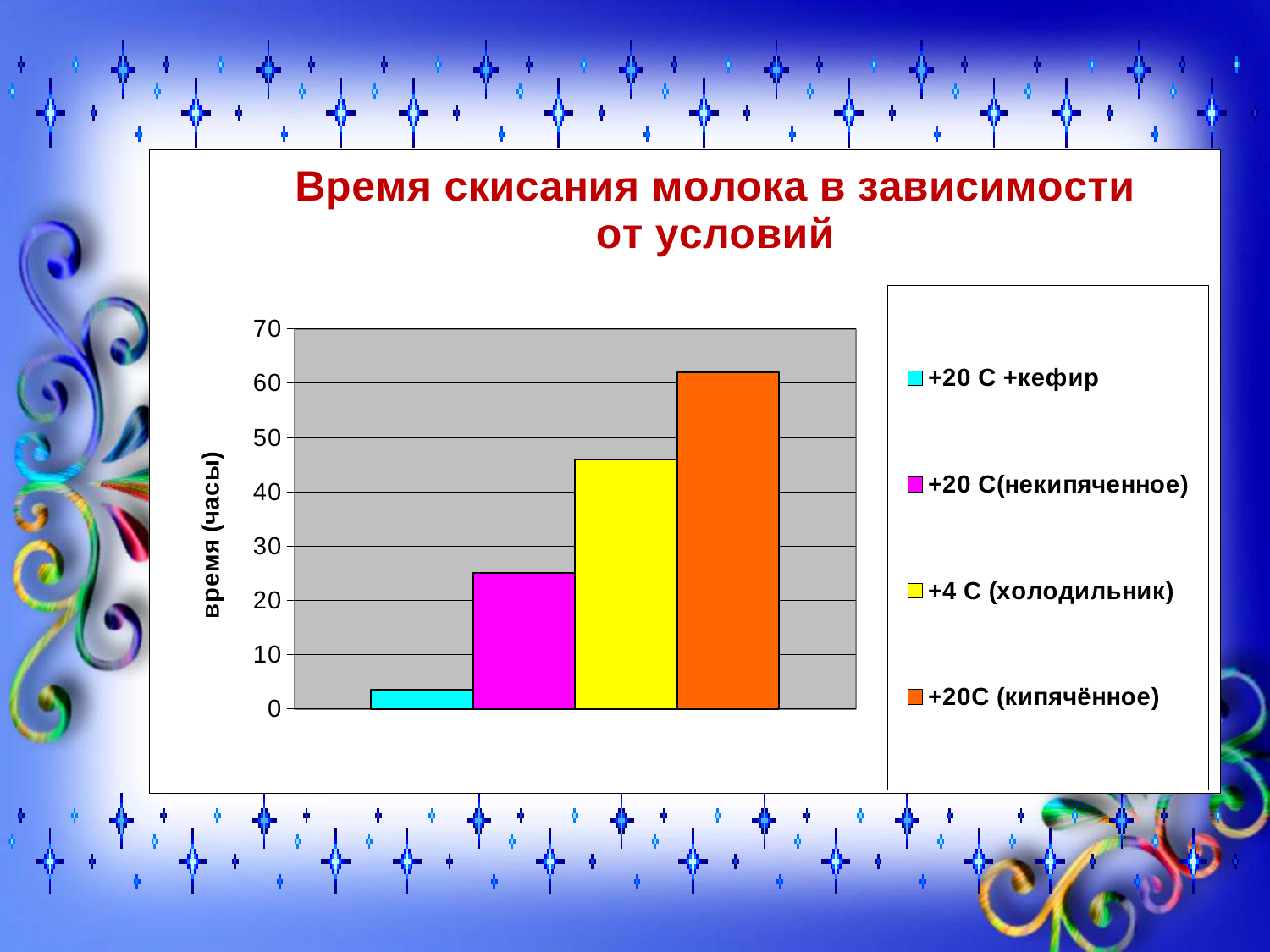
Which series has the lowest value? +20 C +кефир What kind of chart is shown on the slide? bar chart Is the value for +4 C (холодильник) greater or less than 50? less Which is larger, the value for +4 C (холодильник) or the value for +20 C(некипяченное)? +4 C (холодильник) Is the value for +20 C +кефир greater or less than 10? less Is the value for +20C (кипячённое) greater or less than 60? greater What is the title of the chart? Время скисания молока в зависимости от условий What is the label of the vertical axis? время (часы) Which series has the highest value? +20C (кипячённое) How many series does the legend list? 4 How many bars are plotted in the chart? 4